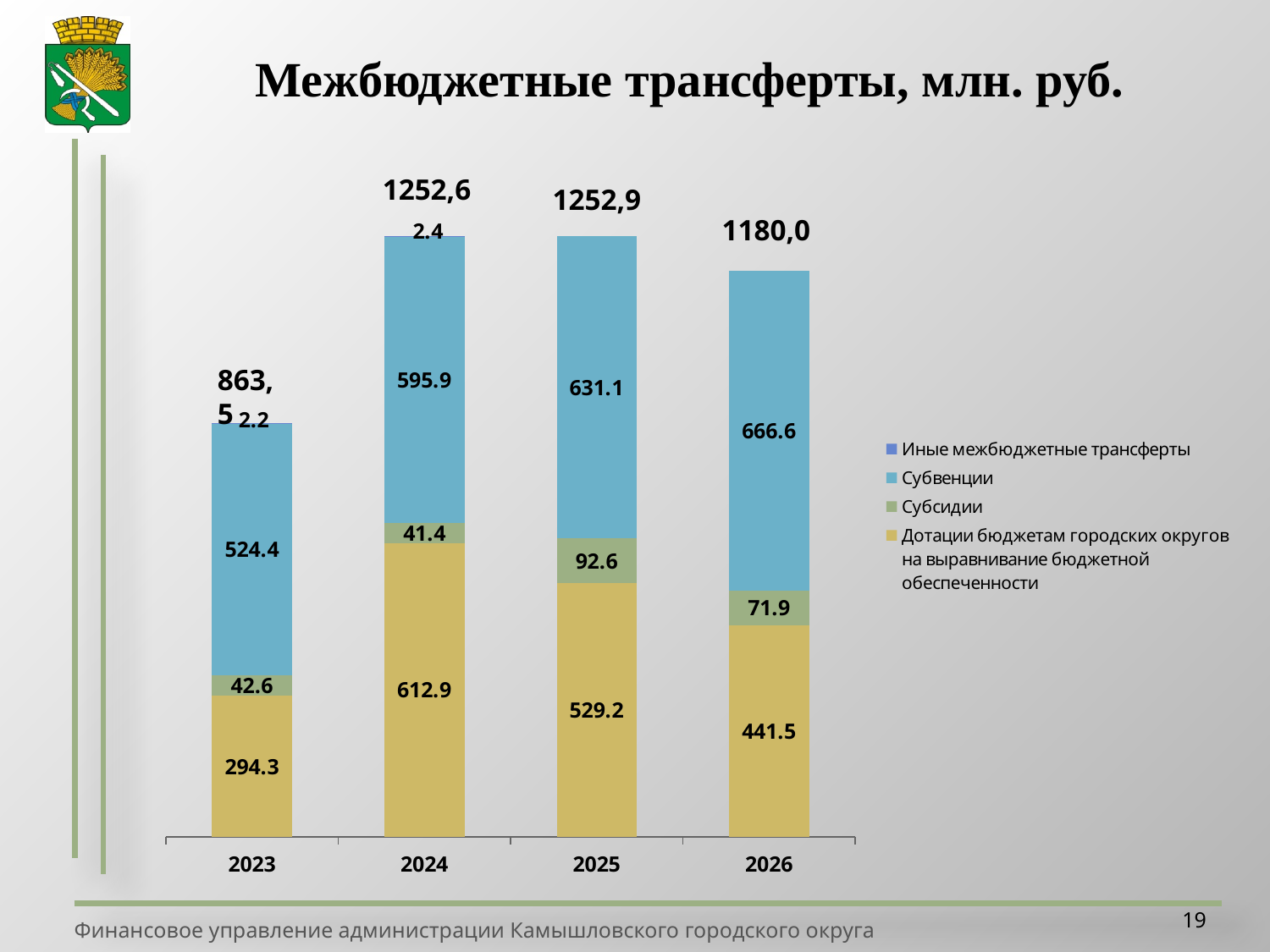
How many years are shown on the x axis? 4 What is the value of Иные межбюджетные трансферты for 2024? 2.4 What type of chart is shown on the slide? stacked bar chart Which is larger: Субсидии in 2025 or Субсидии in 2026? Субсидии in 2025 What is the value of Субвенции for 2025? 631.1 How many series does the legend list? 4 What is the difference between the Дотации values for 2024 and 2023? 318.6 What is the value of Субсидии for 2023? 42.6 Which year has the lowest total of intergovernmental transfers? 2023 What is the total of the stacked bar for 2026? 1180,0 What is the value of Дотации бюджетам городских округов на выравнивание бюджетной обеспеченности for 2026? 441.5 In which year is the value of Субвенции the highest? 2026